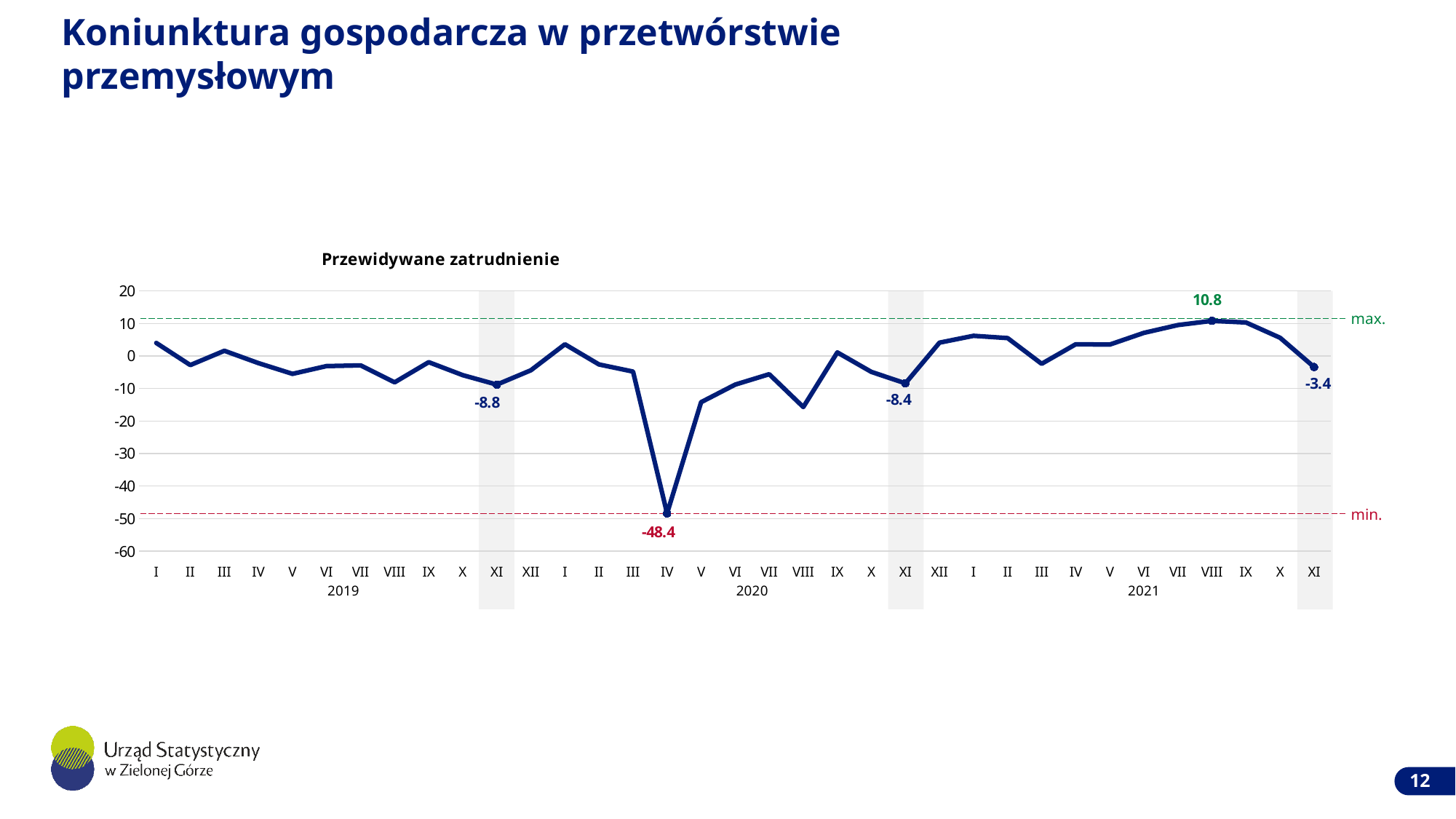
Is the value for VIII 2020 greater or less than -10? less What is the title of the chart? Przewidywane zatrudnienie What is the value for XI 2020? -8.4 What is the value for XI 2019? -8.8 Which month has the lowest value on the chart? IV 2020 What is the difference between the value for VIII 2021 and the value for IV 2020? 59.2 What is the value for IV 2020? -48.4 Which month has the highest value on the chart? VIII 2021 What is the value for XI 2021? -3.4 What is the value for VIII 2021? 10.8 Which is larger, the value for XI 2019 or the value for XI 2021? XI 2021 What type of chart is shown on the slide? line chart